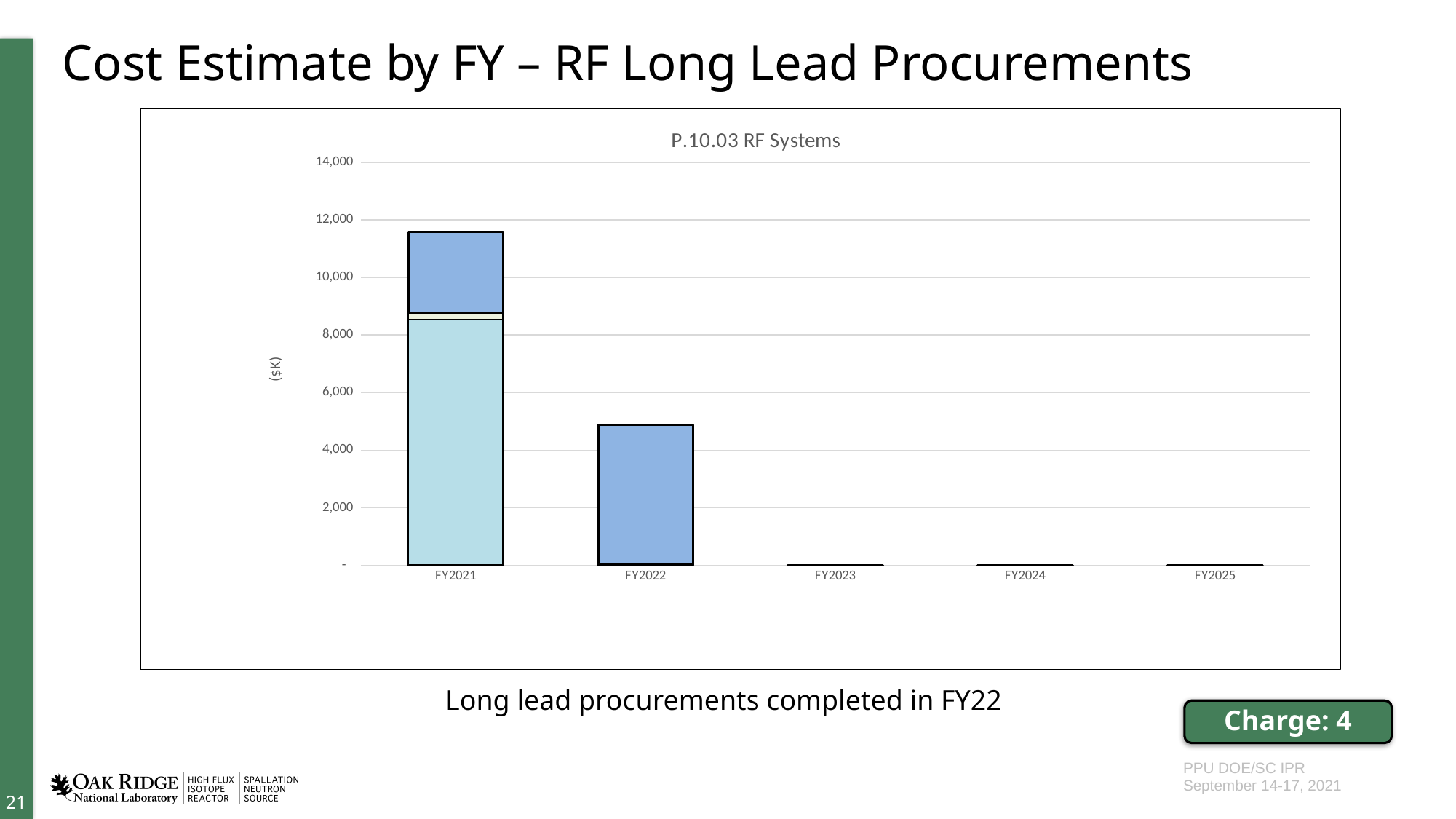
Is the value for FY2022 greater or less than 4,000? greater Is the total value for FY2021 greater or less than 12,000? less Which fiscal year has the highest total cost estimate? FY2021 What kind of chart is shown on the slide? bar chart Which is larger, the value for FY2021 or the value for FY2022? FY2021 Is the value for FY2023 greater or less than 2,000? less What is the title of the chart? P.10.03 RF Systems What unit is shown on the y-axis label of the chart? ($K) Do the values rise or fall from FY2021 to FY2023? fall How many fiscal year categories are shown on the x axis? 5